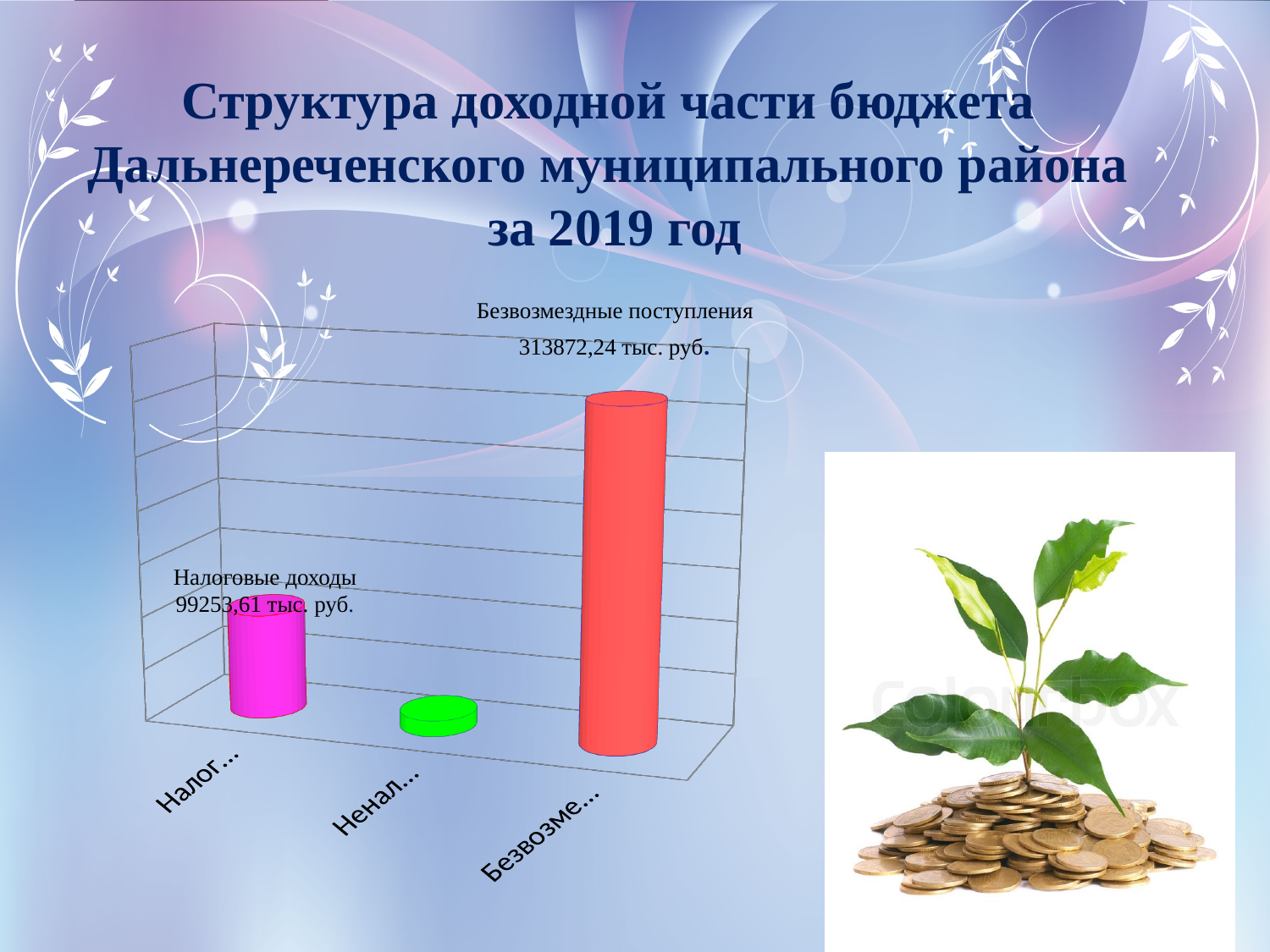
What is the value for Безвозмездные поступления? 313872,24 тыс. руб. What colour is the bar for Безвозмездные поступления? Red Which category has the lowest bar? Ненал... Which category has the highest bar? Безвозмездные поступления Which is larger, the bar for Налог... or the bar for Ненал...? Налог... What kind of chart is shown on the slide? Bar chart What is the difference between Безвозмездные поступления and Налоговые доходы? 214618,63 тыс. руб. What is the title of the slide? Структура доходной части бюджета Дальнереченского муниципального района за 2019 год How many categories are shown in the chart? 3 Which is larger, Налоговые доходы or Безвозмездные поступления? Безвозмездные поступления What is the value for Налоговые доходы? 99253,61 тыс. руб.